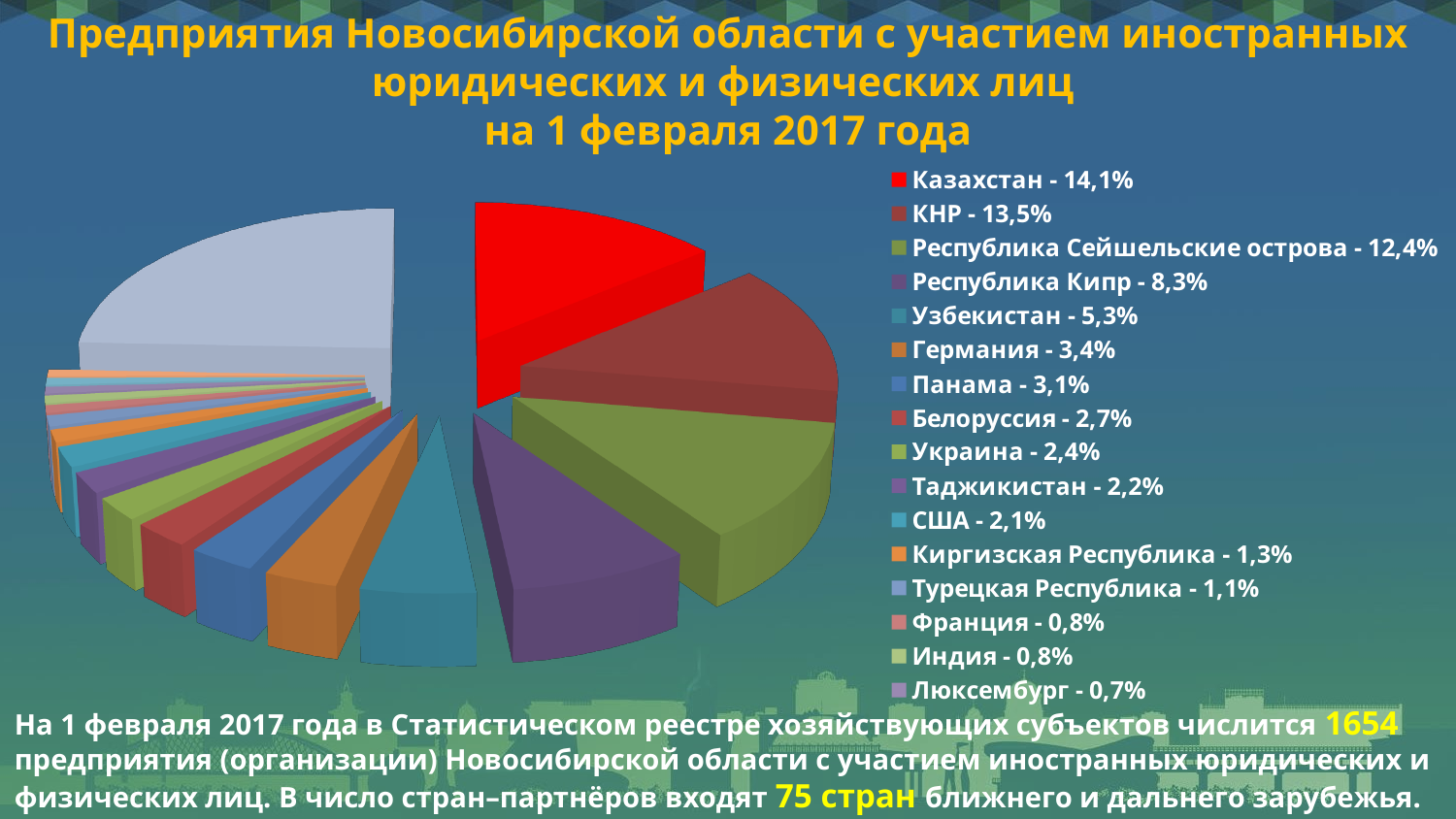
Among the countries listed in the legend, which has the smallest share? Люксембург Which has the larger share, Германия or Панама? Германия What share does Казахстан have according to the legend? 14,1% What type of chart is shown on the slide? pie chart What share is shown for КНР? 13,5% What share is shown for Республика Кипр? 8,3% What share is shown for Узбекистан? 5,3% What is the combined share of Франция and Индия? 1,6% What share is shown for США? 2,1% By how many percentage points does the share of Казахстан exceed that of КНР? 0,6 How many countries are listed in the chart legend? 16 Among the countries listed in the legend, which has the largest share? Казахстан